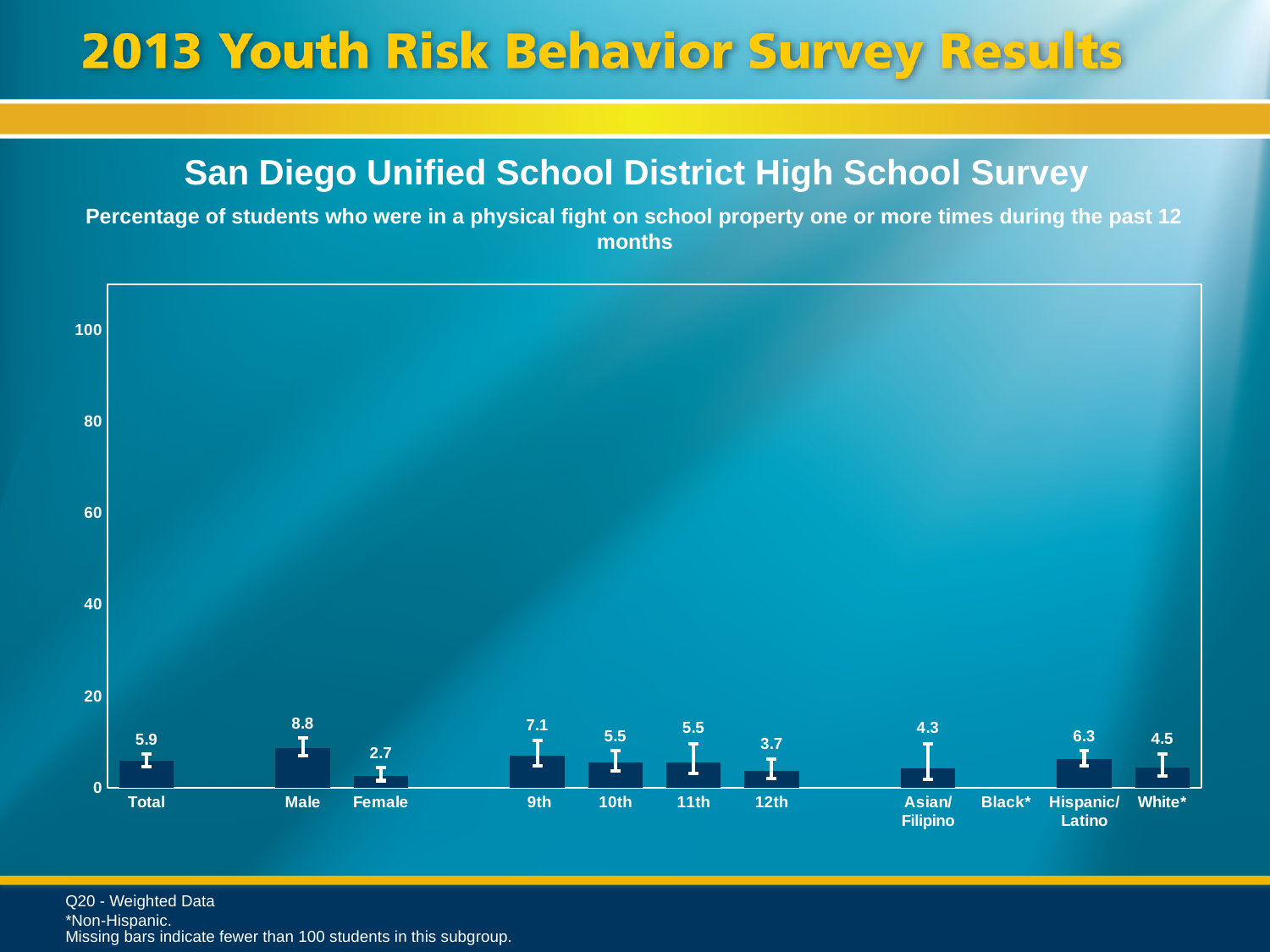
What is the difference between the Male and Female values? 6.1 How many categories are labelled on the x axis? 11 Is the value for Total greater or less than 20? less Which category with a plotted bar has the lowest value? Female What is the value for 9th grade? 7.1 Which category has the highest value? Male What kind of chart is shown? bar chart What is the value for Male? 8.8 What is the value for Hispanic/Latino? 6.3 What is the value for Female? 2.7 Which is larger, the value for 9th grade or the value for 12th grade? 9th Which category label has no bar plotted? Black*